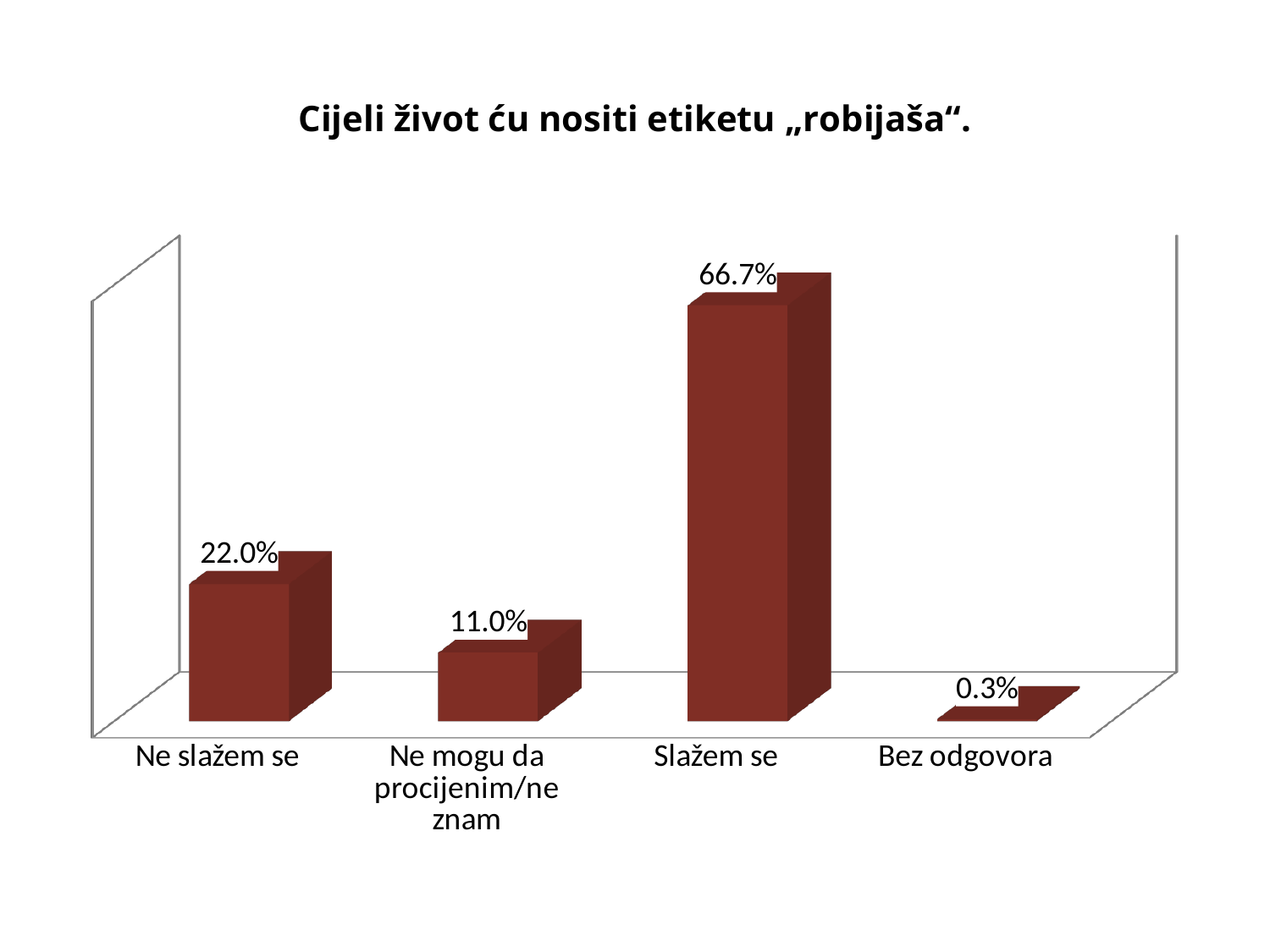
What is the value for "Bez odgovora"? 0.3% Which category has the lowest value? Bez odgovora How many categories are shown in the chart? 4 What is the value for "Ne slažem se"? 22.0% What is the value for "Ne mogu da procijenim/ne znam"? 11.0% What kind of chart is shown on the slide? Bar chart Which is larger, the value for "Ne slažem se" or the value for "Ne mogu da procijenim/ne znam"? Ne slažem se What is the title of the chart? Cijeli život ću nositi etiketu „robijaša“. What is the value for "Slažem se"? 66.7% What is the difference between the values for "Slažem se" and "Ne slažem se"? 44.7% Which category has the highest value? Slažem se What is the difference between the values for "Ne slažem se" and "Ne mogu da procijenim/ne znam"? 11.0%